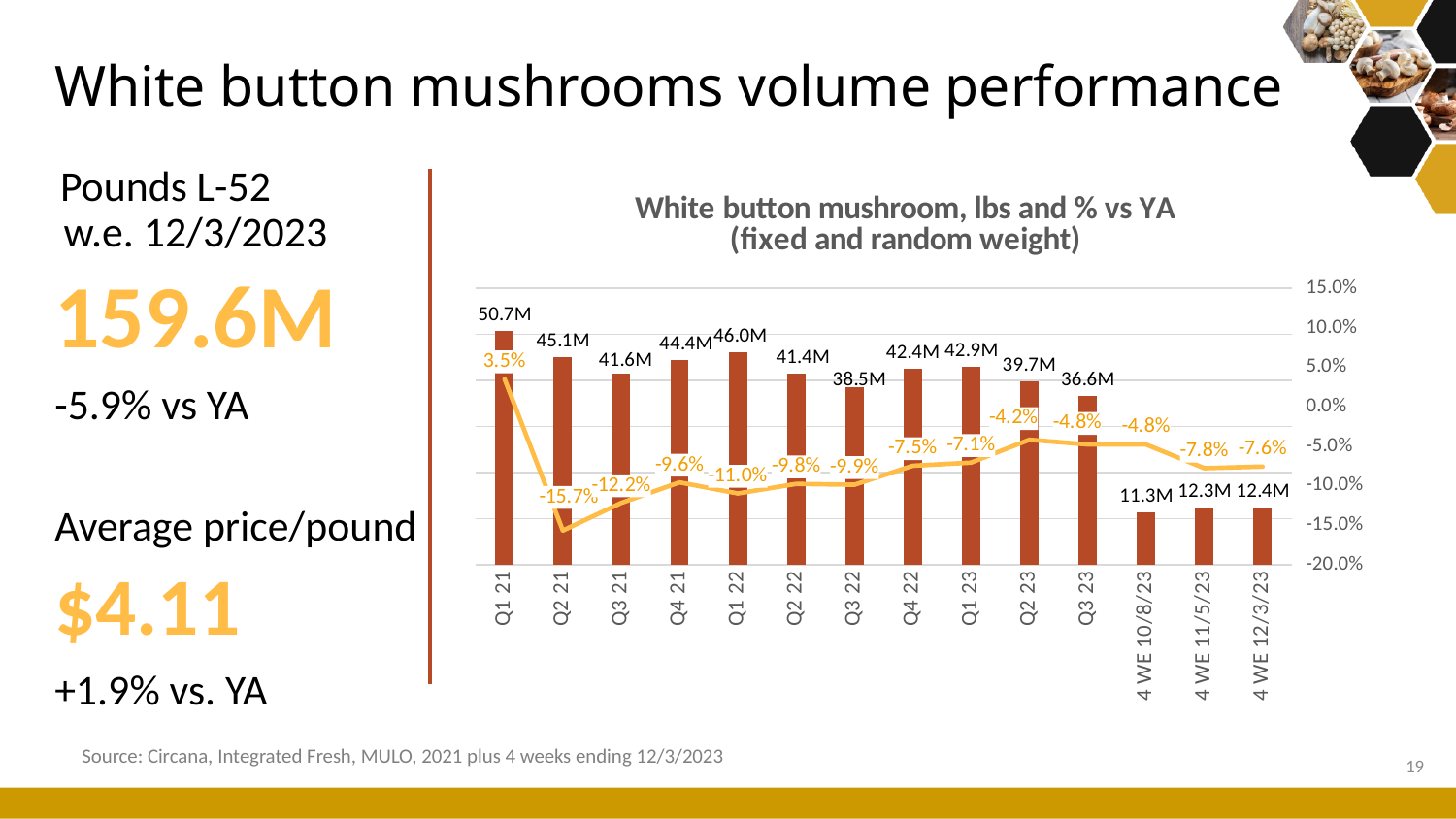
What kind of chart is this? Combination bar and line chart Which period has the highest lbs value? Q1 21 How many periods are shown on the x axis? 14 Which period has the lowest % vs YA value? Q2 21 Does the % vs YA line rise or fall from Q2 21 to Q2 23? Rise What is the lbs value for Q1 21? 50.7M Which period has the lowest lbs value? 4 WE 10/8/23 What is the difference in lbs between Q1 22 and Q2 22? 4.6M What is the lbs value for Q3 23? 36.6M Which has the larger lbs value, Q4 22 or Q1 23? Q1 23 What is the % vs YA value for 4 WE 12/3/23? -7.6% What is the % vs YA value for Q2 21? -15.7%